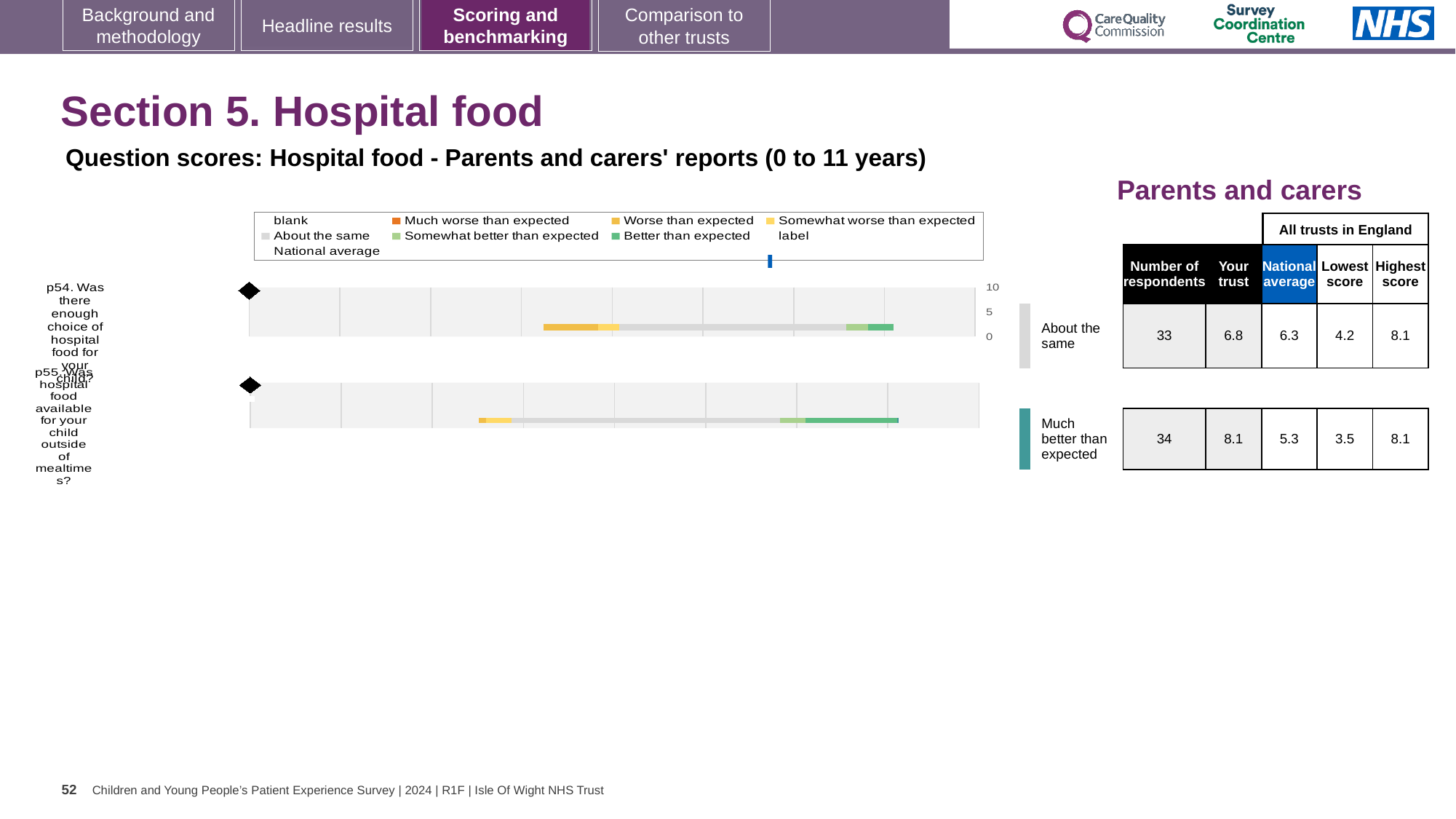
How many survey questions are plotted on this slide? 2 What kind of chart is used to show the question scores? bar chart What benchmark category is shown for question p55 (hospital food available outside of mealtimes)? Much better than expected Which question has the higher 'Your trust' score, p54 or p55? p55 What is the national average score for question p55 (hospital food available outside of mealtimes)? 5.3 By how much does the trust's score for p55 exceed the national average for p55? 2.8 What is the lowest score among all trusts in England for question p55? 3.5 What is the difference between the highest and lowest scores for question p54? 3.9 What is the 'Your trust' score for question p54 (enough choice of hospital food)? 6.8 How many respondents are listed for question p54 (enough choice of hospital food)? 33 Is the trust's score for question p55 greater or less than 5? greater What is the highest score among all trusts in England for question p54? 8.1